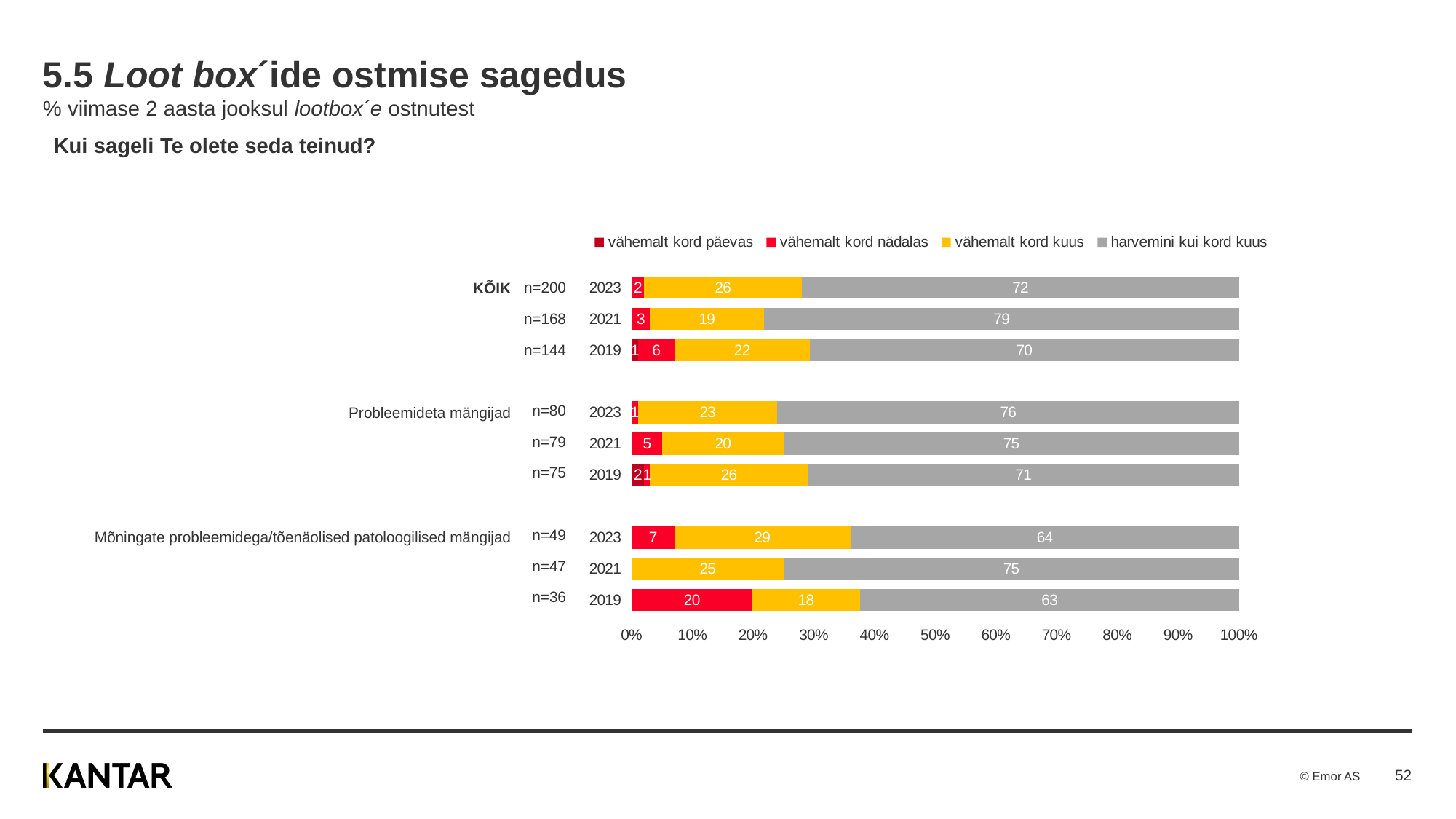
What is the 'vähemalt kord kuus' value for 'Mõningate probleemidega/tõenäolised patoloogilised mängijad' in 2023? 29 What is the 'vähemalt kord nädalas' value for 'Mõningate probleemidega/tõenäolised patoloogilised mängijad' in 2019? 20 How many series does the legend list? 4 How many bars are plotted in the chart? 9 For KÕIK, what is the difference between the 'harvemini kui kord kuus' values in 2021 and 2023? 7 What colour represents 'harvemini kui kord kuus' in the chart? Grey What percentage of all respondents (KÕIK) in 2023 bought loot boxes 'harvemini kui kord kuus'? 72 Which bar has the lowest 'harvemini kui kord kuus' value? Mõningate probleemidega/tõenäolised patoloogilised mängijad 2019 What is the 'vähemalt kord kuus' value for KÕIK in 2021? 19 Which bar has the highest 'harvemini kui kord kuus' value? KÕIK 2021 For 'Probleemideta mängijad', is the 'vähemalt kord kuus' value larger in 2023 or in 2021? 2023 What kind of chart is shown on the slide? Stacked bar chart